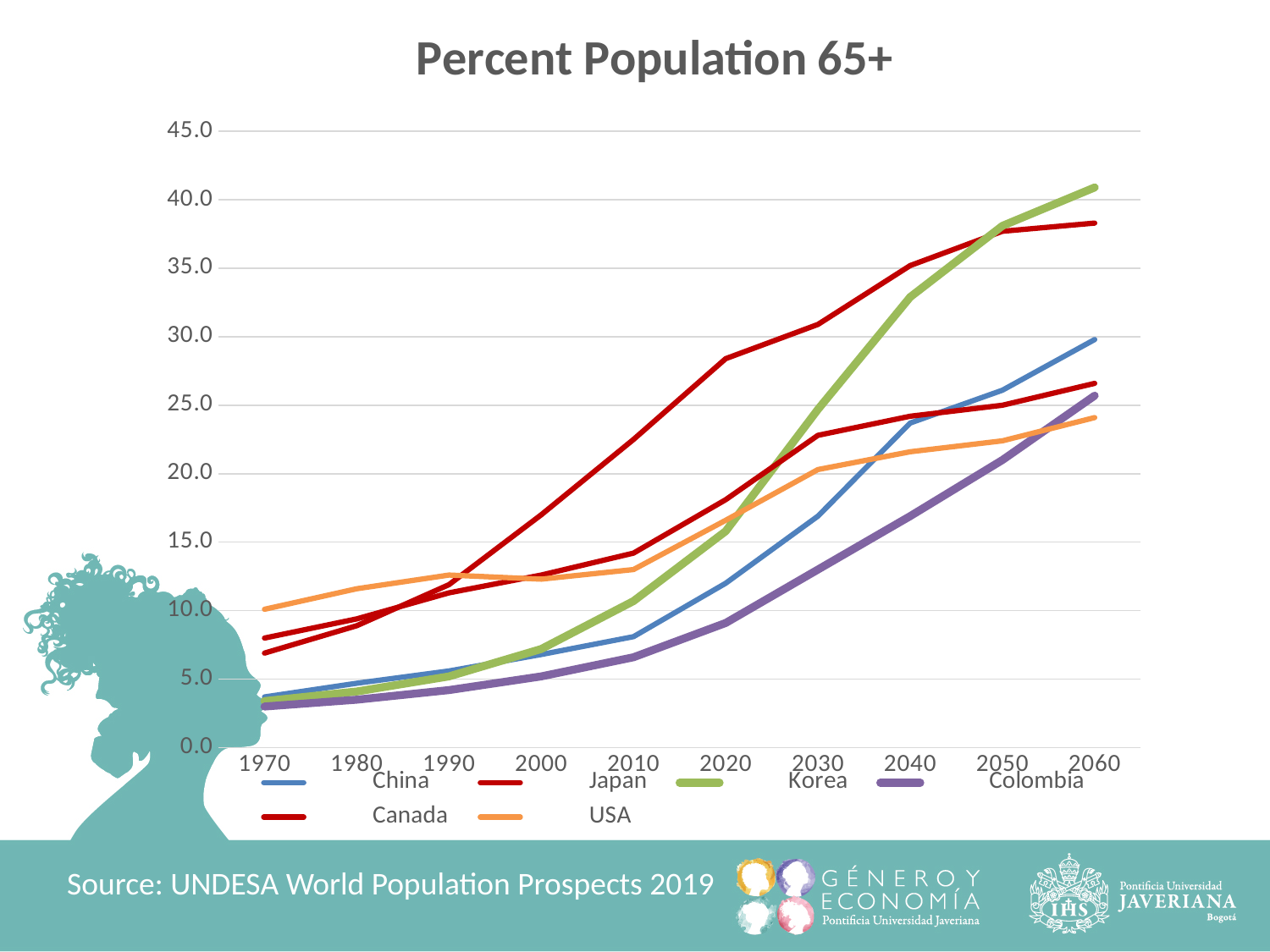
In 2030, which is larger, the value for China or the value for USA? USA Is the value for Colombia in 2020 greater or less than 10.0? less Is the value for USA in 2060 greater or less than 25.0? less Which series has the highest value in 2060? Korea Is the value for Korea in 2020 greater or less than 20.0? less What is the title of the chart? Percent Population 65+ Does the value for Korea rise or fall from 1970 to 2060? rises What kind of chart is shown on the slide? line chart How many years are shown on the x axis? 10 How many series does the legend list? 6